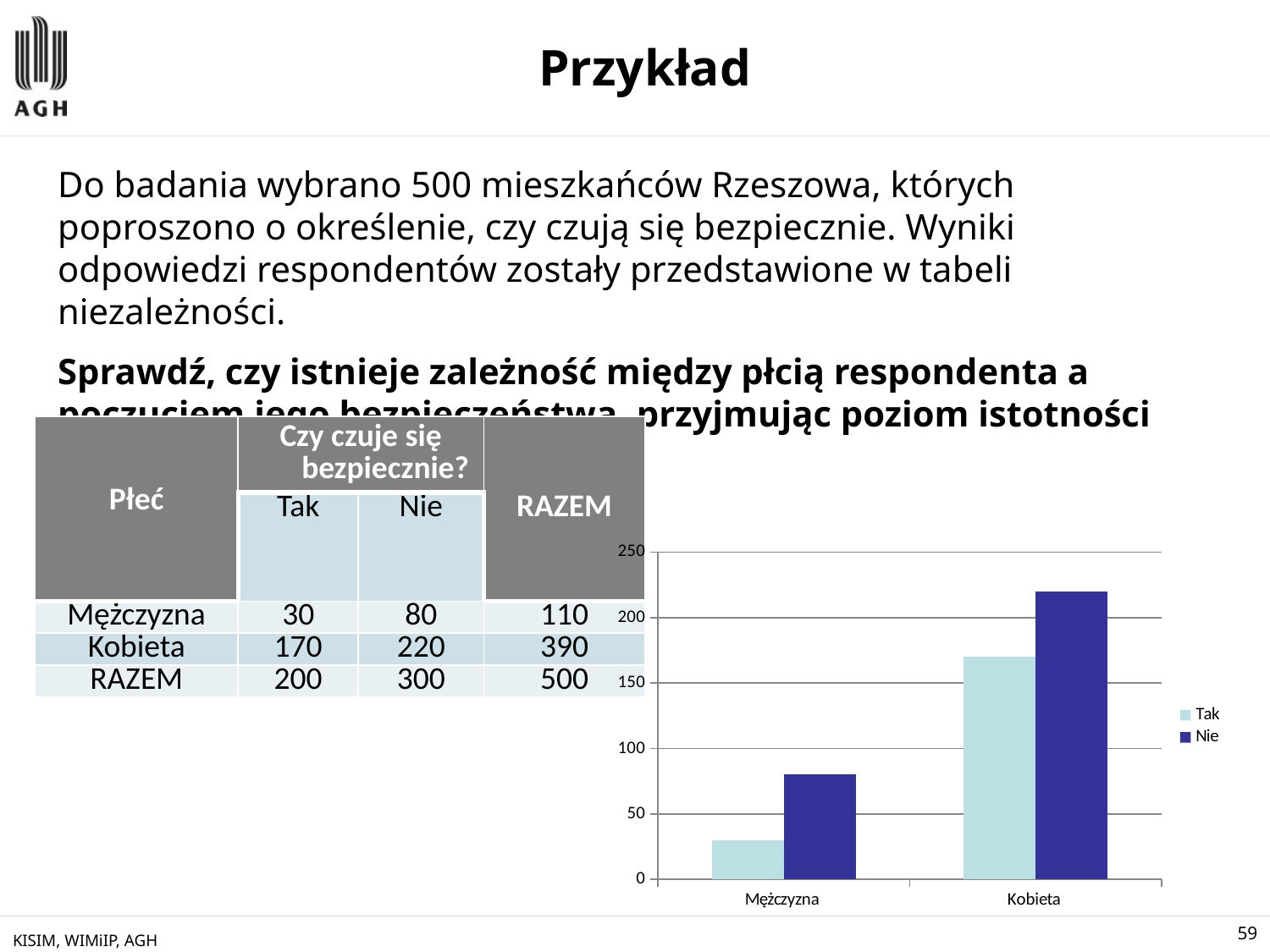
Which series in the chart is shown in dark blue? Nie Which category has the highest Nie bar in the chart? Kobieta According to the table on the slide, what is the Tak value plotted for Kobieta? 170 Is the value of the Nie bar for Mężczyzna greater or less than 100? less Which category has the lowest Tak bar in the chart? Mężczyzna Is the value of the Tak bar for Kobieta greater or less than 150? greater Is the value of the Nie bar for Kobieta greater or less than 200? greater For Kobieta, which bar is taller, Tak or Nie? Nie How many categories are shown on the x axis of the chart? 2 What kind of chart is shown on the slide? bar chart How many series does the chart legend list? 2